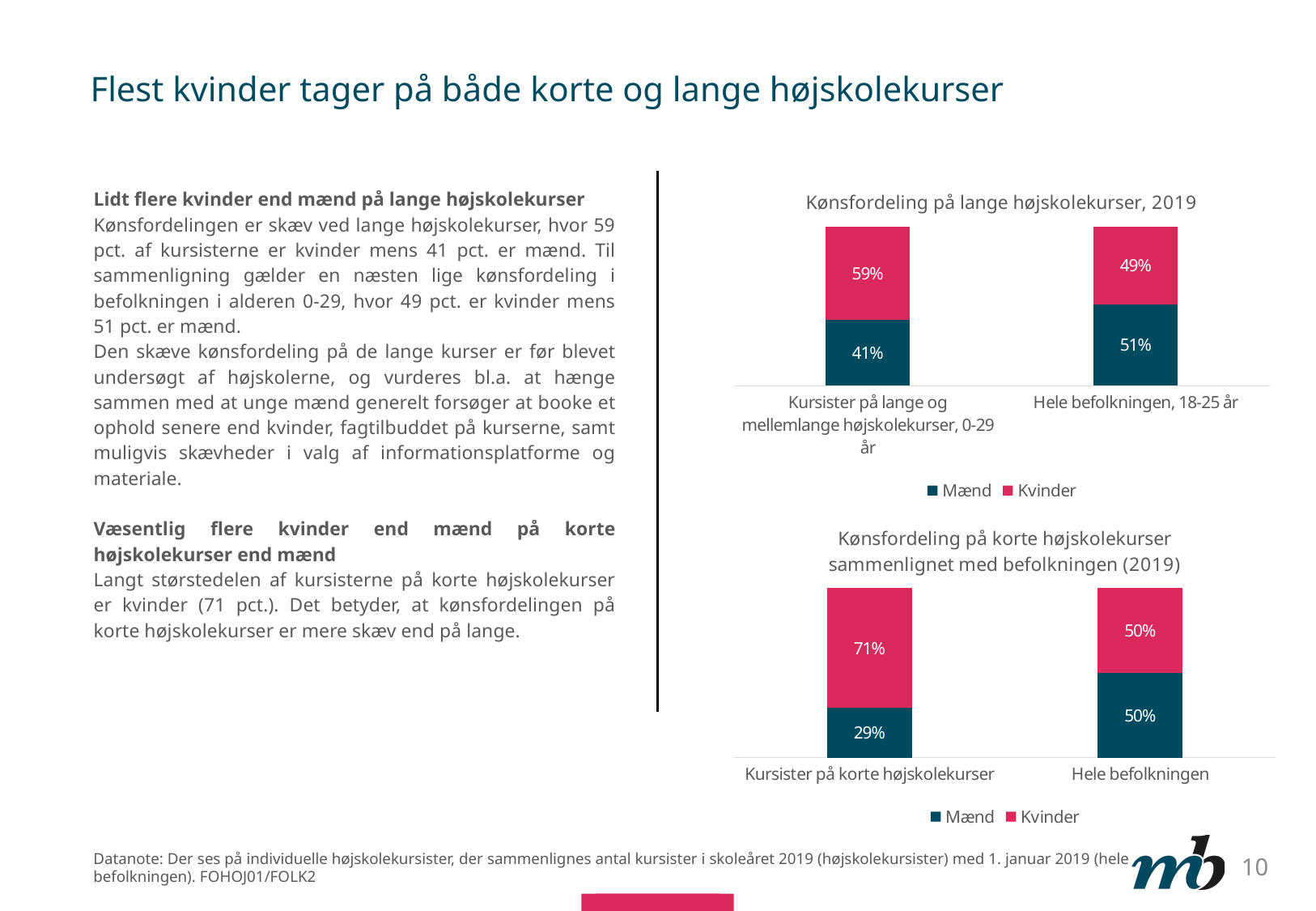
In the chart 'Kønsfordeling på lange højskolekurser, 2019', what is the Mænd value for 'Hele befolkningen, 18-25 år'? 51% In the chart 'Kønsfordeling på lange højskolekurser, 2019', which colour represents Kvinder? Pink/red In the bottom chart 'Kønsfordeling på korte højskolekurser sammenlignet med befolkningen (2019)', what is the difference between the Kvinder and Mænd values for 'Kursister på korte højskolekurser'? 42% In the bottom chart 'Kønsfordeling på korte højskolekurser sammenlignet med befolkningen (2019)', what is the Mænd value for 'Kursister på korte højskolekurser'? 29% In the bottom chart 'Kønsfordeling på korte højskolekurser sammenlignet med befolkningen (2019)', how many categories are shown on the x axis? 2 In the chart 'Kønsfordeling på lange højskolekurser, 2019', which is larger for 'Hele befolkningen, 18-25 år': Mænd or Kvinder? Mænd In the chart 'Kønsfordeling på lange højskolekurser, 2019', how many series does the legend list? 2 In the chart 'Kønsfordeling på lange højskolekurser, 2019', what is the Kvinder value for 'Kursister på lange og mellemlange højskolekurser, 0-29 år'? 59% What type of chart is the bottom chart 'Kønsfordeling på korte højskolekurser sammenlignet med befolkningen (2019)'? Stacked bar chart In the bottom chart 'Kønsfordeling på korte højskolekurser sammenlignet med befolkningen (2019)', what is the Kvinder value for 'Hele befolkningen'? 50% In the chart 'Kønsfordeling på lange højskolekurser, 2019', what is the difference between the Kvinder and Mænd values for 'Kursister på lange og mellemlange højskolekurser, 0-29 år'? 18% In the bottom chart 'Kønsfordeling på korte højskolekurser sammenlignet med befolkningen (2019)', what is the Kvinder value for 'Kursister på korte højskolekurser'? 71%